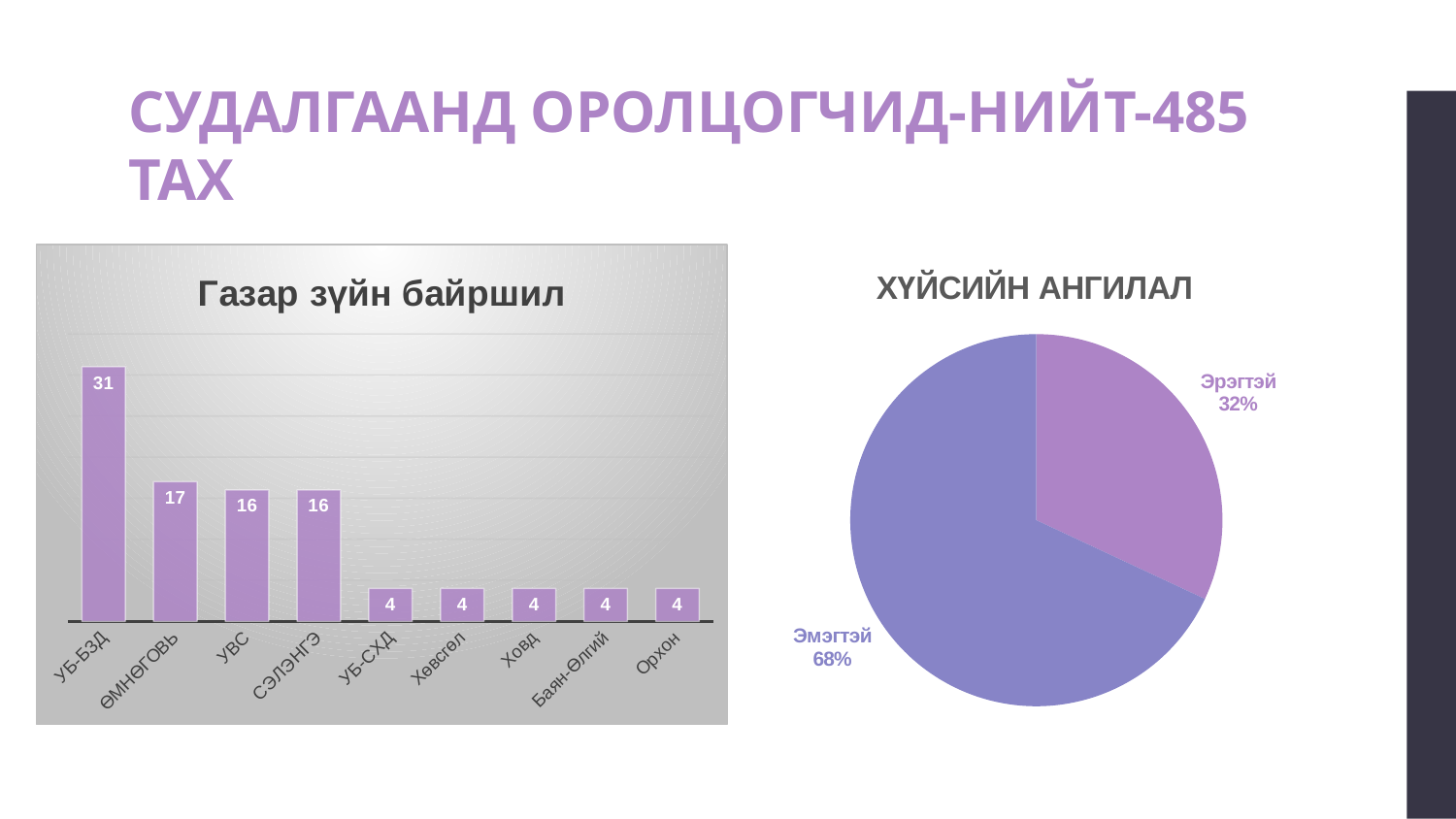
How many categories are shown in the 'Газар зүйн байршил' chart? 9 What kind of chart is 'ХҮЙСИЙН АНГИЛАЛ'? Pie chart In the 'Газар зүйн байршил' chart, which category has the highest value? УБ-БЗД In the 'Газар зүйн байршил' chart, what is the difference between the values for УБ-БЗД and ӨМНӨГОВЬ? 14 In the 'Газар зүйн байршил' chart, what is the value for УБ-БЗД? 31 In the 'Газар зүйн байршил' chart, what is the value for СЭЛЭНГЭ? 16 In the 'Газар зүйн байршил' chart, what is the value for ӨМНӨГОВЬ? 17 In the 'Газар зүйн байршил' chart, how many categories have a value of 4? 5 In the 'ХҮЙСИЙН АНГИЛАЛ' chart, what share does Эмэгтэй have? 68% What kind of chart is 'Газар зүйн байршил'? Bar chart In the 'ХҮЙСИЙН АНГИЛАЛ' chart, what share does Эрэгтэй have? 32% In the 'Газар зүйн байршил' chart, which is larger, the value for УВС or the value for Орхон? УВС